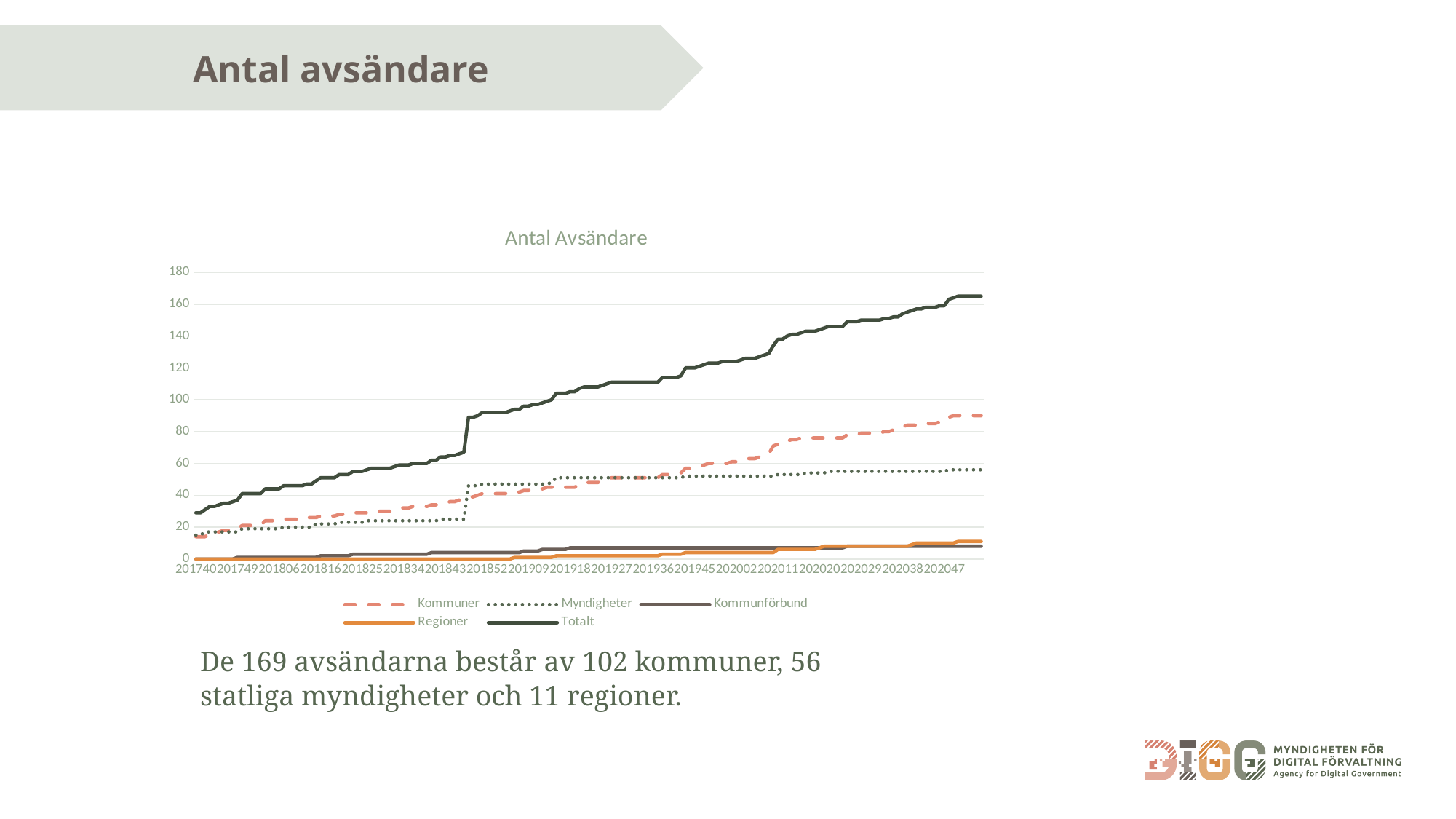
Does the Totalt line rise or fall along the x axis? rise Which series is plotted as a dashed line in the chart? Kommuner Is the value of Regioner at the right end of the chart greater or less than 20? less What kind of chart is shown on the slide? line chart How many series does the legend of the chart list? 5 Is the value of Totalt at the left end of the chart (201740) greater or less than 20? greater Which series has the highest values throughout the chart? Totalt Is the value of Kommuner at the right end of the chart greater or less than 80? greater At the right end of the chart, which series is larger, Kommuner or Myndigheter? Kommuner What is the title of the chart? Antal Avsändare